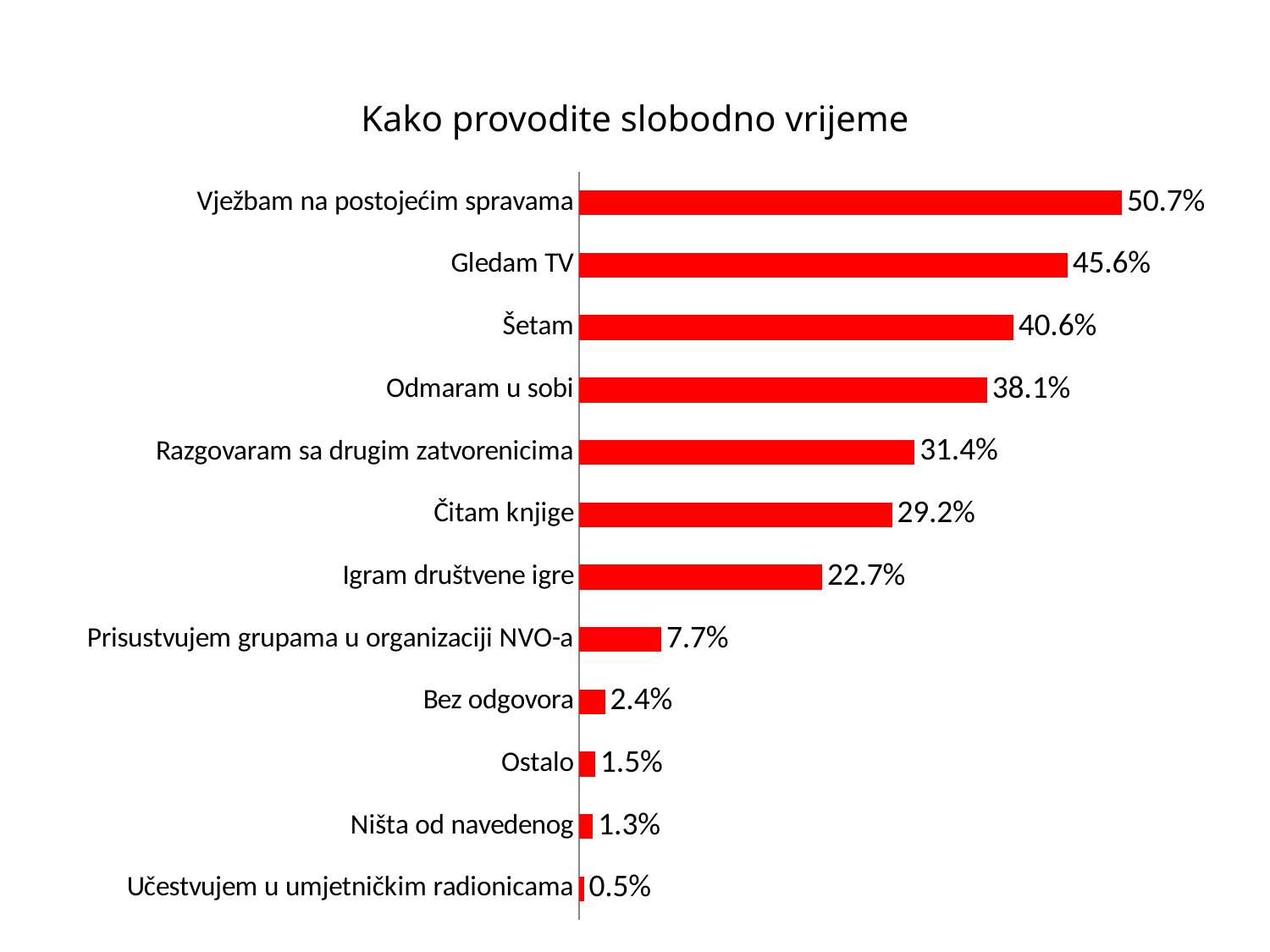
Which is larger, the value for "Ostalo" or the value for "Bez odgovora"? Bez odgovora What is the title of the chart? Kako provodite slobodno vrijeme What is the value for "Prisustvujem grupama u organizaciji NVO-a"? 7.7% What is the value for "Čitam knjige"? 29.2% Which is larger, the value for "Odmaram u sobi" or the value for "Razgovaram sa drugim zatvorenicima"? Odmaram u sobi What is the value for "Gledam TV"? 45.6% Which category has the highest value? Vježbam na postojećim spravama What kind of chart is shown on the slide? Bar chart What is the difference between the values for "Vježbam na postojećim spravama" and "Gledam TV"? 5.1% How many categories are shown in the chart? 12 Which category has the lowest value? Učestvujem u umjetničkim radionicama What is the difference between the values for "Šetam" and "Igram društvene igre"? 17.9%